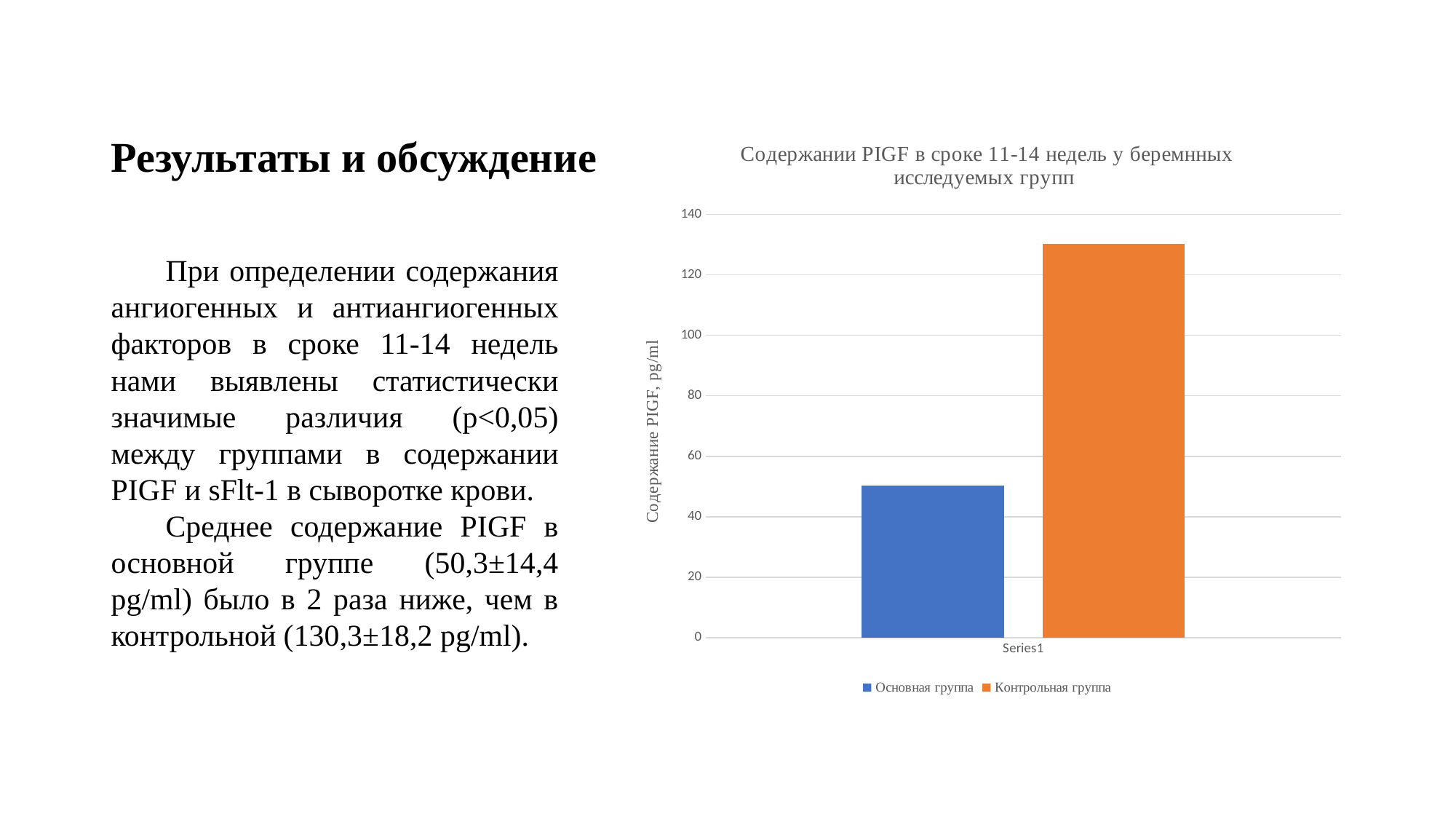
Is the value for Основная группа greater or less than 40? greater How many series does the legend list? 2 What is the label of the y axis of the chart? Содержание PIGF, pg/ml Is the value for Контрольная группа greater or less than 140? less What colour is the bar for Контрольная группа? orange Is the value for Основная группа greater or less than 60? less Which is larger, the bar for Основная группа or the bar for Контрольная группа? Контрольная группа Which group has the lower PIGF value in the chart? Основная группа Which group has the higher PIGF value in the chart? Контрольная группа What kind of chart is shown on the slide? bar chart How many categories are shown on the x axis of the chart? 1